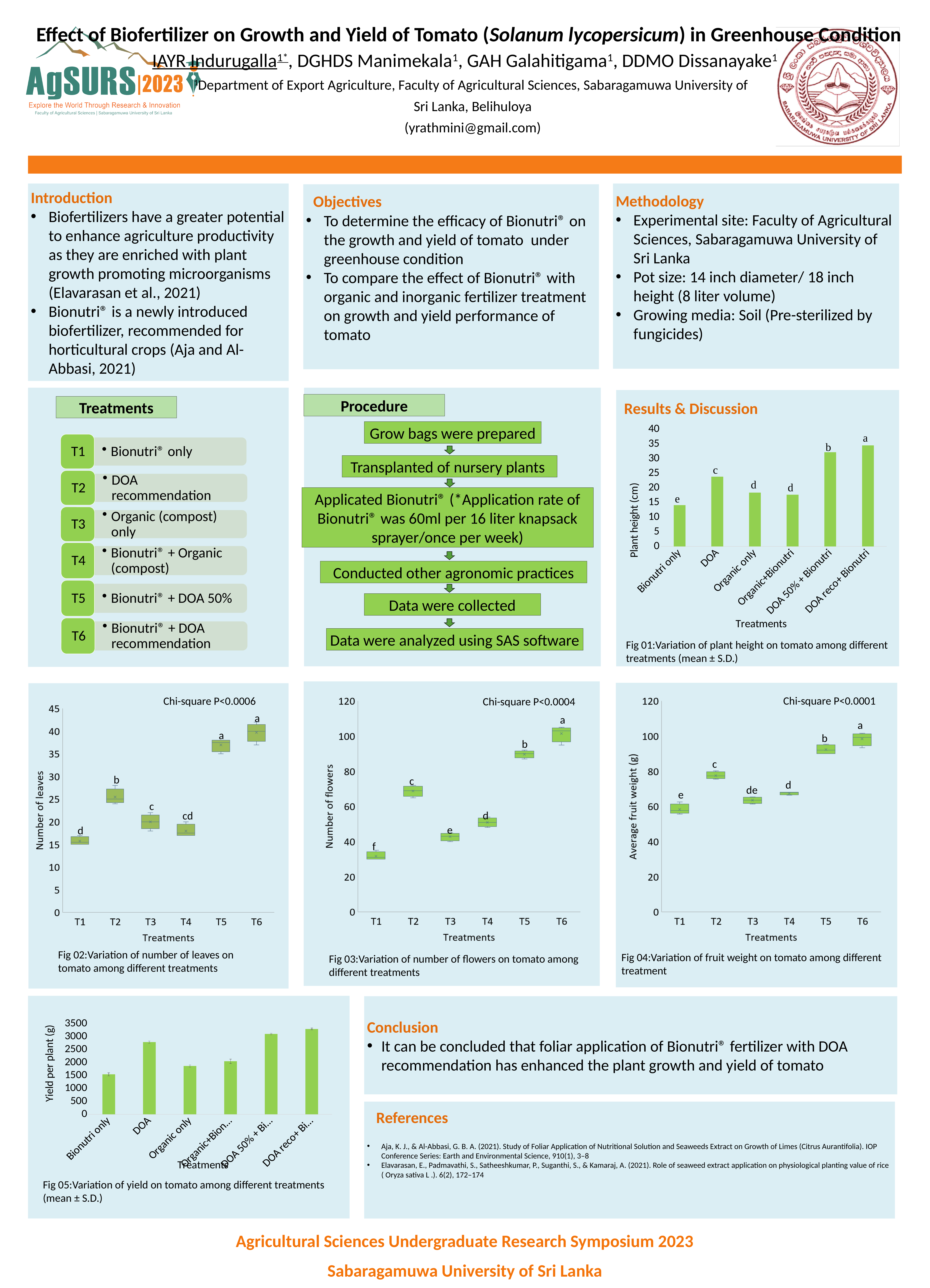
In Fig 05 (yield per plant chart), is the yield for Bionutri only greater or less than 2000 g? less What Chi-square P value is printed on Fig 04 (average fruit weight chart)? P<0.0001 In Fig 01 (plant height chart), is the plant height for DOA 50% + Bionutri greater or less than 30 cm? greater In Fig 01 (plant height chart), which treatment has the tallest plants? DOA reco+ Bionutri How many treatments are plotted in Fig 01 (plant height chart)? 6 What kind of chart is Fig 05 (yield per plant)? bar chart In Fig 04 (average fruit weight chart), is the value for T5 greater or less than 80 g? greater In Fig 05 (yield per plant chart), which treatment has the highest yield? DOA reco+ Bionutri In Fig 01 (plant height chart), which treatment has the lowest plant height? Bionutri only In Fig 05 (yield per plant chart), which is larger, the yield for DOA or the yield for Organic only? DOA In Fig 02 (number of leaves chart), which treatment has the highest number of leaves? T6 In Fig 03 (number of flowers chart), which treatment has the lowest number of flowers? T1